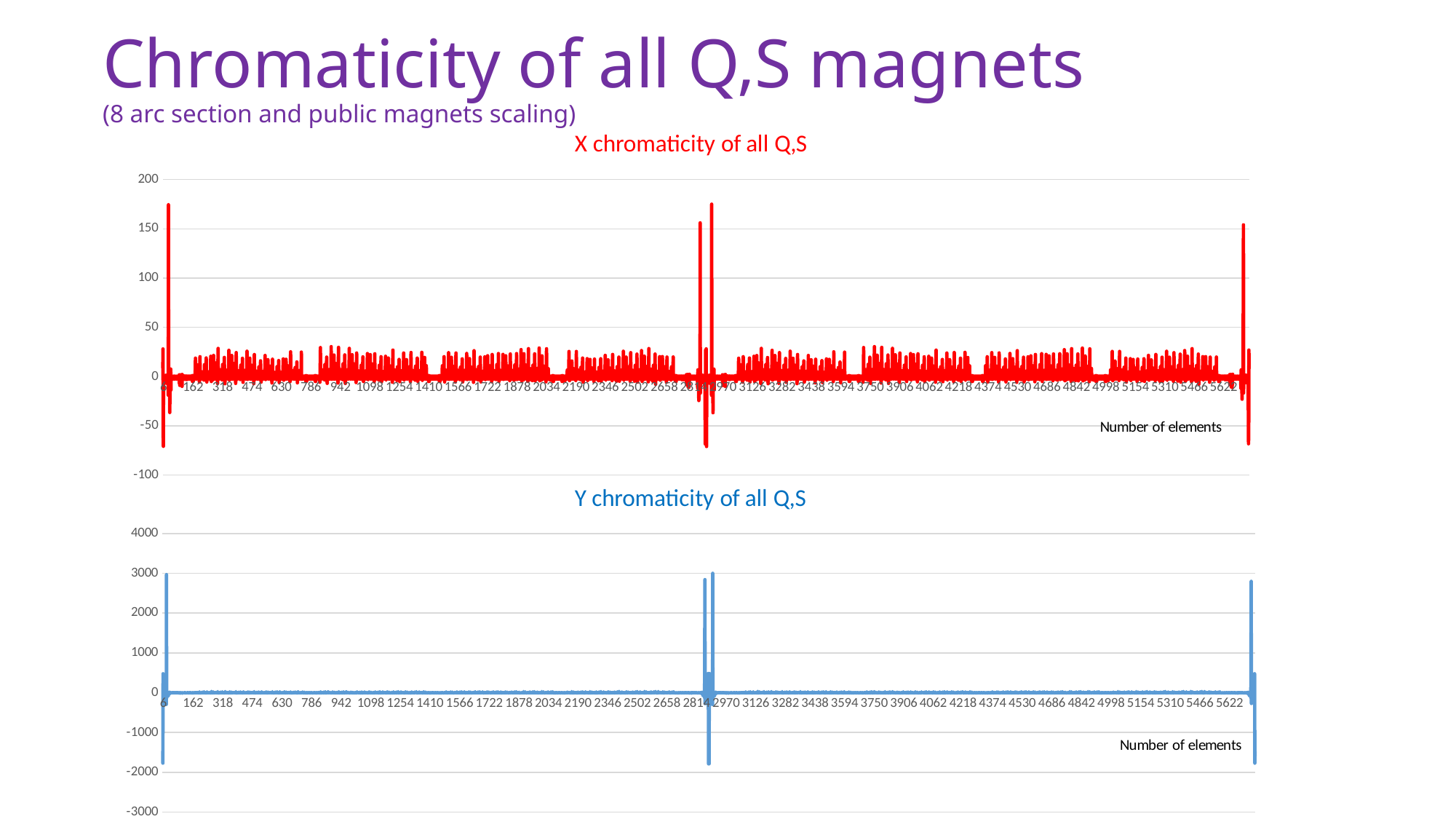
In the 'X chromaticity of all Q,S' chart, is the highest peak greater or less than 150? greater In the 'Y chromaticity of all Q,S' chart, is the highest peak greater or less than 2000? greater In the 'X chromaticity of all Q,S' chart, is the lowest value greater or less than -50? less What is the title of the top chart on the slide? X chromaticity of all Q,S In the 'X chromaticity of all Q,S' chart, what is the highest value shown on the vertical axis? 200 In the 'Y chromaticity of all Q,S' chart, what is the lowest value shown on the vertical axis? -3000 What kind of chart is the 'Y chromaticity of all Q,S' chart? line chart What kind of chart is the 'X chromaticity of all Q,S' chart? line chart